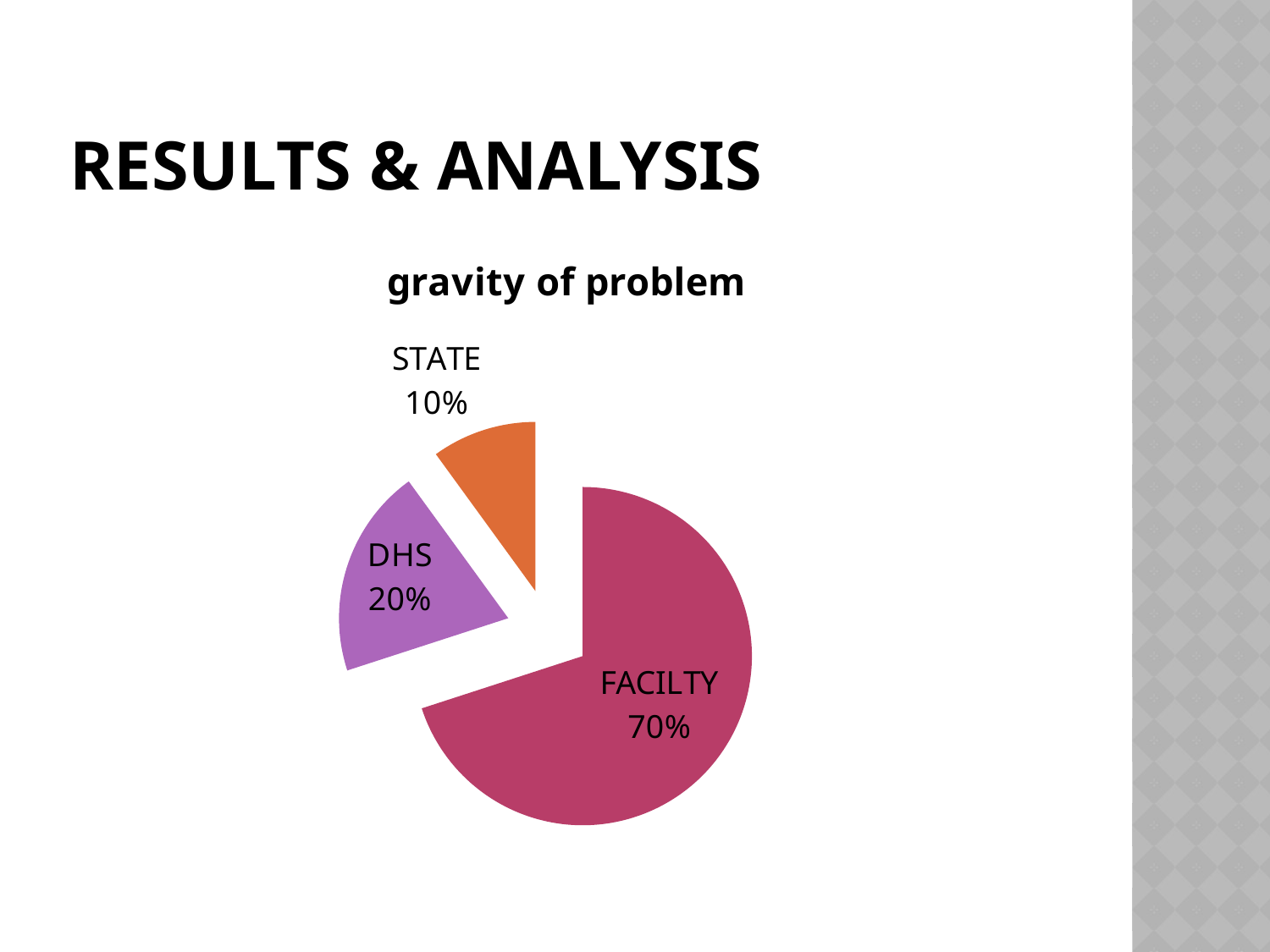
What is the title of the chart? gravity of problem What type of chart is shown on the slide? pie chart What is the difference in percentage points between the FACILTY and DHS slices? 50 How many slices does the pie chart have? 3 What is the difference in percentage points between the DHS and STATE slices? 10 Which category has the smallest share of the pie? STATE What percentage does the DHS slice represent? 20% What percentage does the FACILTY slice represent? 70% What percentage does the STATE slice represent? 10% Which is larger, the DHS slice or the STATE slice? DHS Which category has the largest share of the pie? FACILTY What colour is the FACILTY slice? magenta/pink